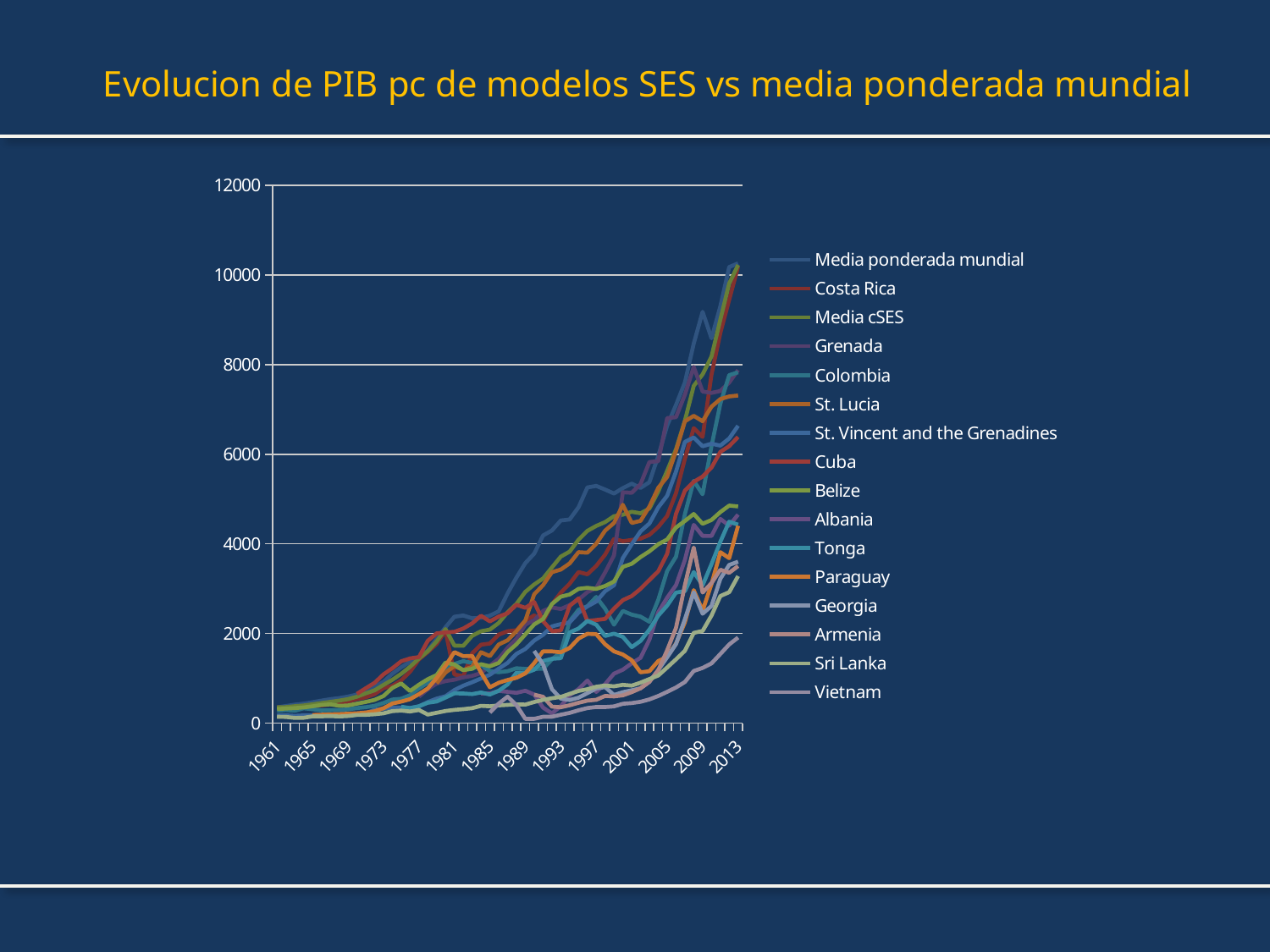
Is the lowest value plotted in 2013 greater or less than 4000? less In 1961, are the plotted values greater or less than 2000? less What kind of chart is shown on the slide? line chart Is the highest value plotted in 2013 greater or less than 8000? greater What is the title of the chart? Evolucion de PIB pc de modelos SES vs media ponderada mundial Do the plotted values generally rise or fall from 1961 to 2013? rise What is the first year shown on the x axis? 1961 What is the last year shown on the x axis? 2013 Which series is listed first in the legend? Media ponderada mundial How many series does the legend list? 16 What is the highest value shown on the y axis? 12000